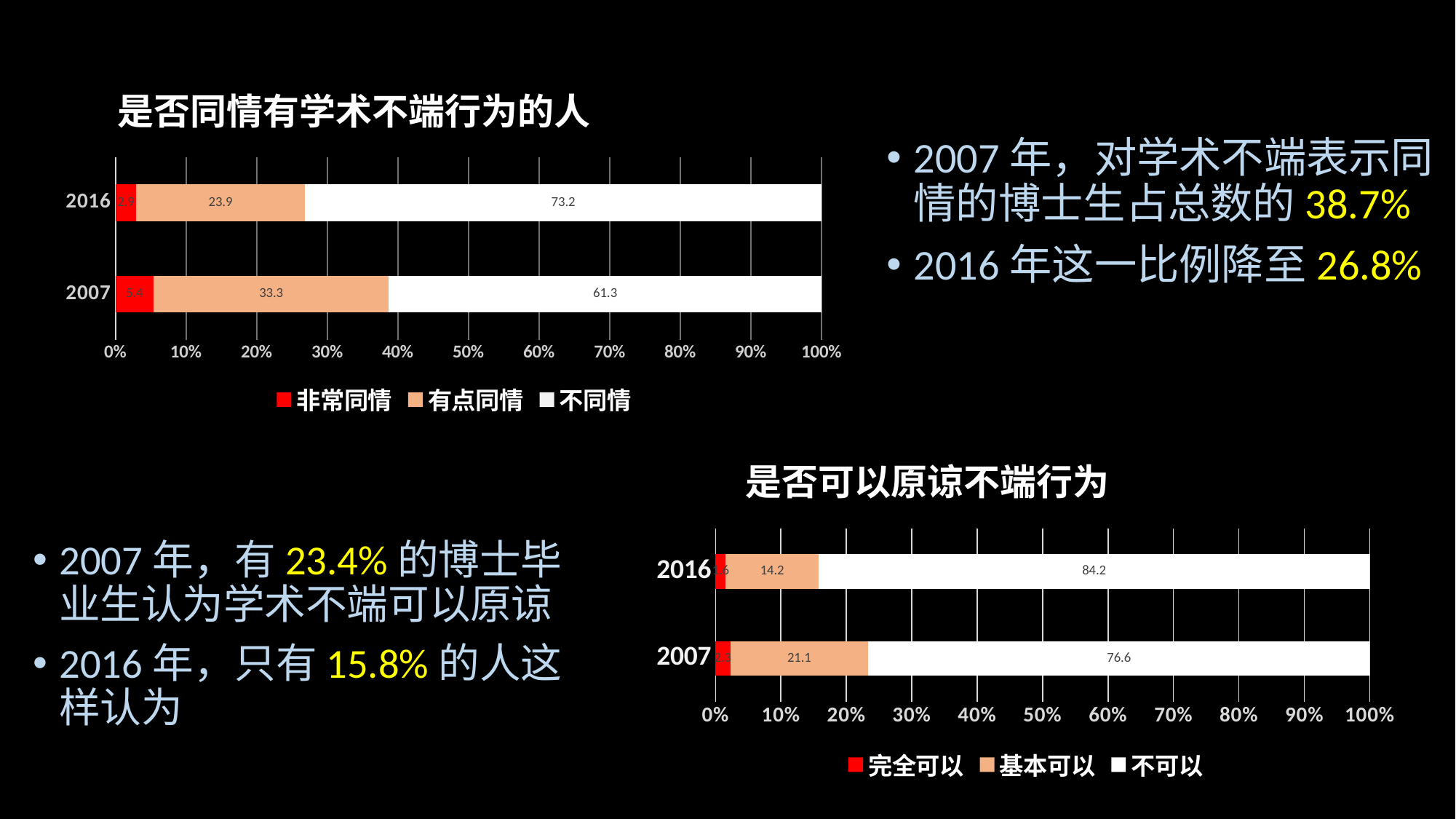
In the chart titled 是否同情有学术不端行为的人, which year has the larger 不同情 value, 2016 or 2007? 2016 In the chart titled 是否同情有学术不端行为的人, what is the value of 有点同情 for 2016? 23.9 In the chart titled 是否可以原谅不端行为, how many years are shown on the vertical axis? 2 In the chart titled 是否同情有学术不端行为的人, what is the value of 非常同情 for 2007? 5.4 In the chart titled 是否同情有学术不端行为的人, what is the value of 不同情 for 2007? 61.3 In the chart titled 是否可以原谅不端行为, which year has the larger 基本可以 value, 2016 or 2007? 2007 What kind of chart is the chart titled 是否可以原谅不端行为? Stacked bar chart In the chart titled 是否可以原谅不端行为, what is the value of 基本可以 for 2007? 21.1 In the chart titled 是否可以原谅不端行为, what is the difference between the 不可以 values for 2016 and 2007? 7.6 In the chart titled 是否可以原谅不端行为, what is the value of 不可以 for 2016? 84.2 In the chart titled 是否同情有学术不端行为的人, what is the difference between the 有点同情 values for 2007 and 2016? 9.4 In the chart titled 是否同情有学术不端行为的人, how many series does the legend list? 3